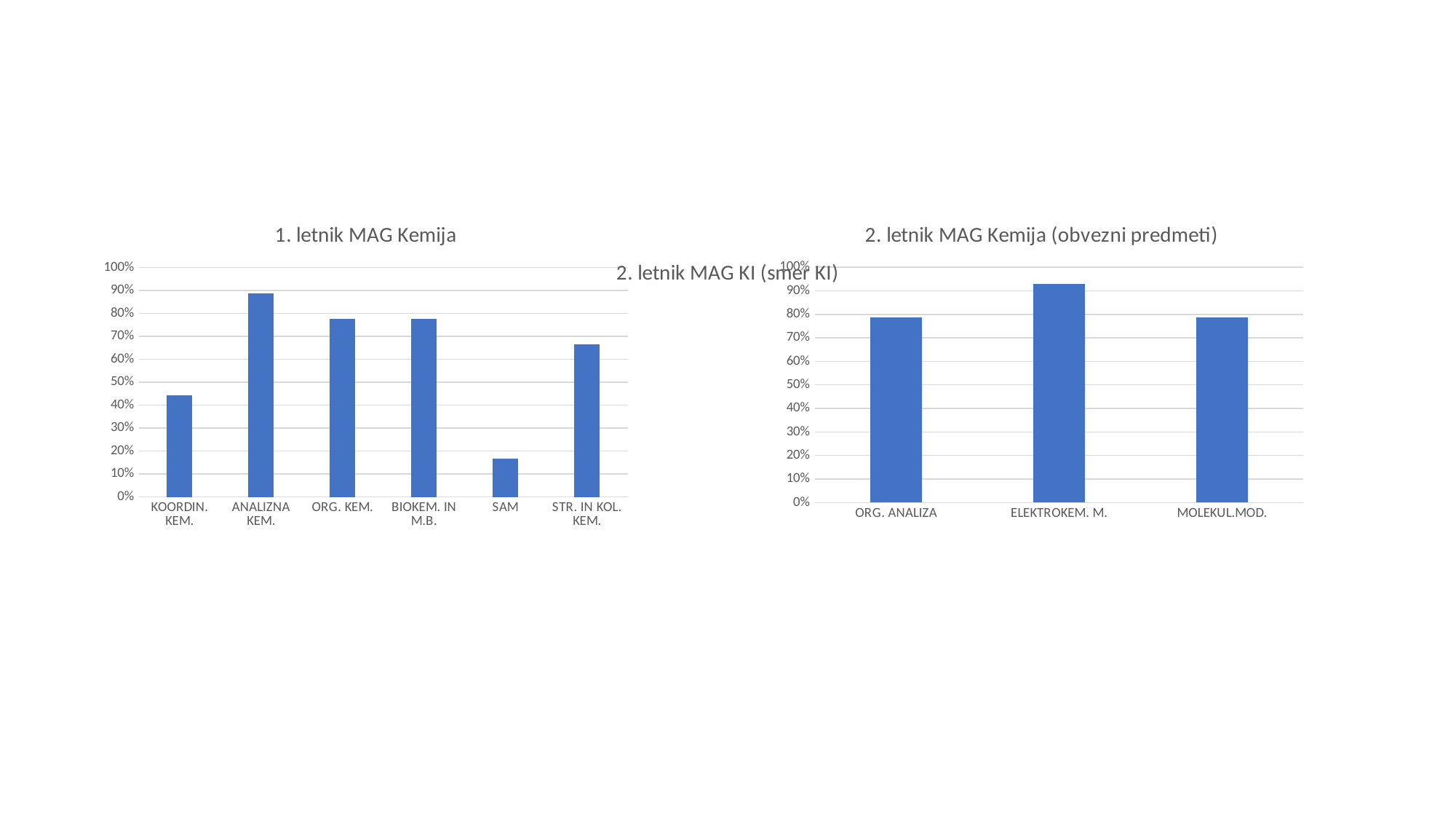
In the chart titled "1. letnik MAG Kemija", is the value for KOORDIN. KEM. greater or less than 50%? less In the chart titled "1. letnik MAG Kemija", which category has the highest value? ANALIZNA KEM. In the chart titled "1. letnik MAG Kemija", is the value for ANALIZNA KEM. greater or less than 80%? greater In the chart titled "1. letnik MAG Kemija", is the value for SAM greater or less than 20%? less In the chart titled "1. letnik MAG Kemija", which is larger, the value for KOORDIN. KEM. or the value for STR. IN KOL. KEM.? STR. IN KOL. KEM. In the chart titled "1. letnik MAG Kemija", which category has the lowest value? SAM What type of chart is the chart titled "2. letnik MAG Kemija (obvezni predmeti)"? bar chart How many categories are shown in the chart titled "2. letnik MAG Kemija (obvezni predmeti)"? 3 In the chart titled "2. letnik MAG Kemija (obvezni predmeti)", which category has the highest value? ELEKTROKEM. M. How many categories are shown in the chart titled "1. letnik MAG Kemija"? 6